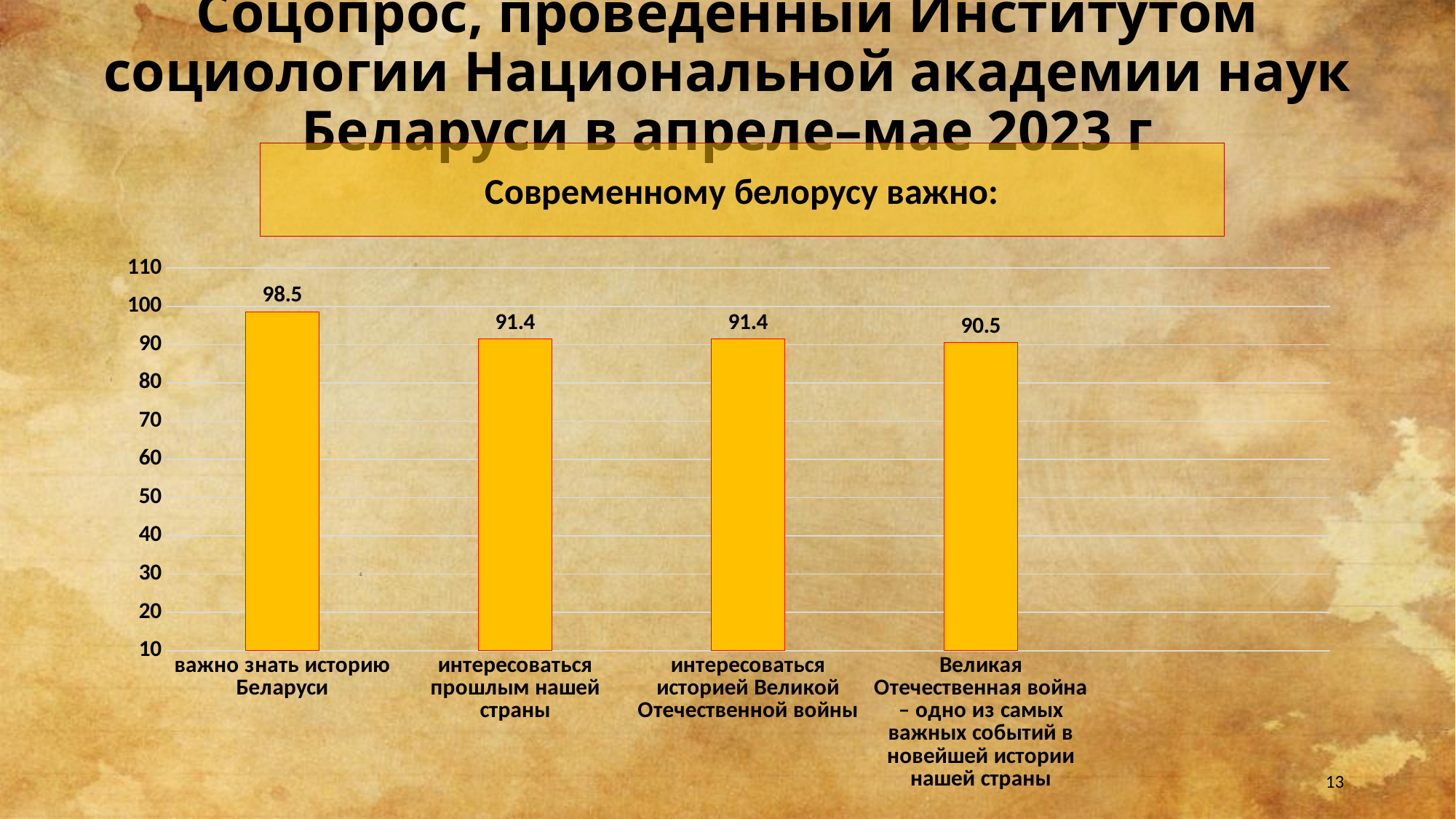
What is the value for "важно знать историю Беларуси"? 98.5 Which category has the highest value? важно знать историю Беларуси How many categories are shown in the chart? 4 What is the value for the category stating that the Great Patriotic War is one of the most important events in the country's recent history ("Великая Отечественная война – одно из самых важных событий в новейшей истории нашей страны")? 90.5 What kind of chart is shown on the slide? bar chart What is the difference between the values for "важно знать историю Беларуси" and "интересоваться прошлым нашей страны"? 7.1 What is the value for "интересоваться историей Великой Отечественной войны"? 91.4 Is the value for "важно знать историю Беларуси" greater or less than 90? greater What is the value for "интересоваться прошлым нашей страны"? 91.4 What is the difference between the values for "важно знать историю Беларуси" and "Великая Отечественная война – одно из самых важных событий в новейшей истории нашей страны"? 8 Which is larger: the value for "важно знать историю Беларуси" or the value for "интересоваться прошлым нашей страны"? важно знать историю Беларуси Which category has the lowest value? Великая Отечественная война – одно из самых важных событий в новейшей истории нашей страны